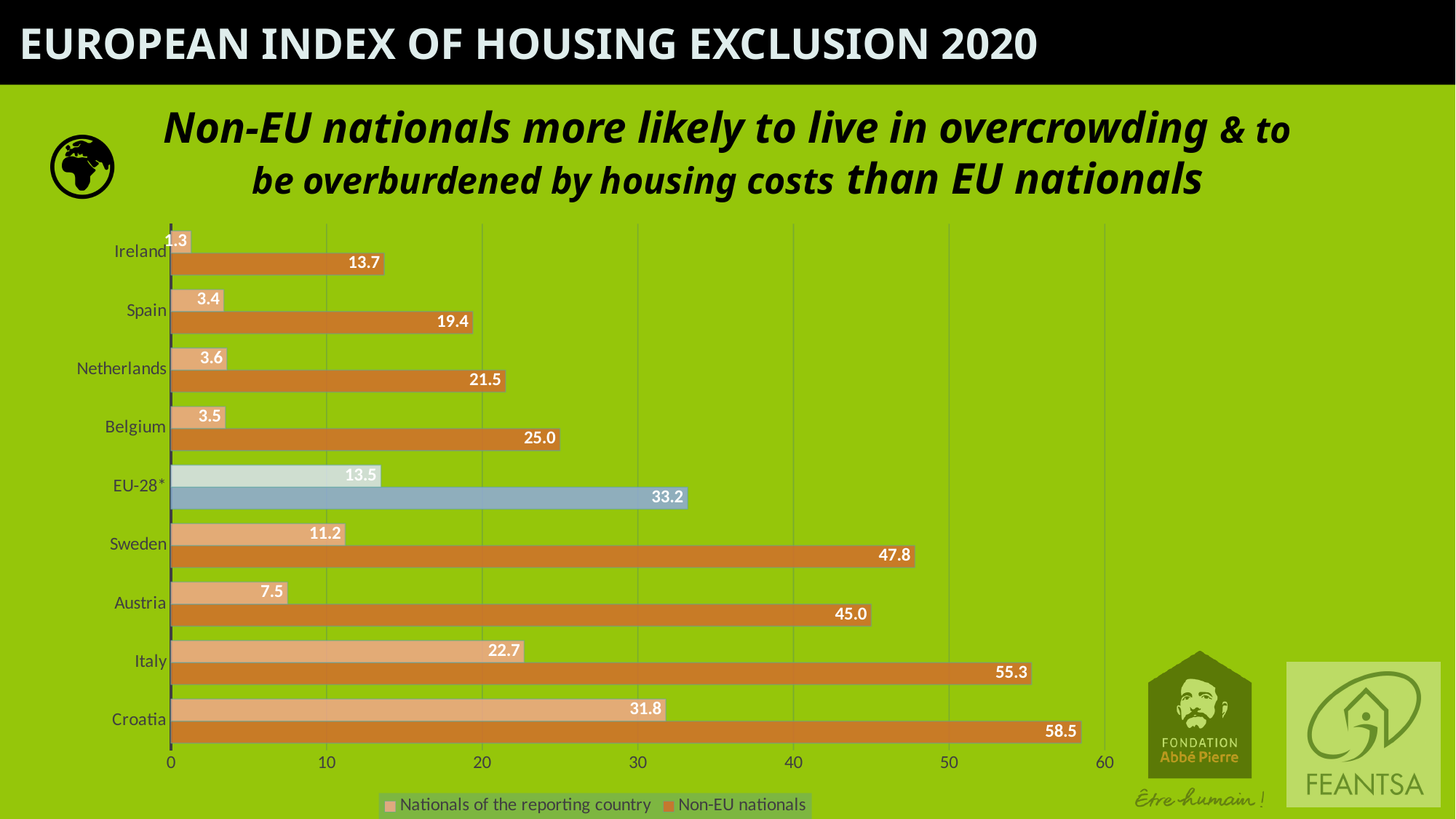
Which category has the lowest value for Nationals of the reporting country? Ireland What is the value for Non-EU nationals for EU-28*? 33.2 Which is larger: the Non-EU nationals value for Austria or for Sweden? Sweden What is the difference between the Non-EU nationals value and the Nationals of the reporting country value for Italy? 32.6 What is the value for Non-EU nationals in Croatia? 58.5 Is the value for Non-EU nationals in Belgium greater or less than 20? greater What are the two series named in the legend? Nationals of the reporting country; Non-EU nationals What kind of chart is shown on the slide? Bar chart How many series does the legend list? 2 What is the value for Nationals of the reporting country in Sweden? 11.2 How many categories are shown on the y axis of the chart? 9 Which category has the highest value for Non-EU nationals? Croatia